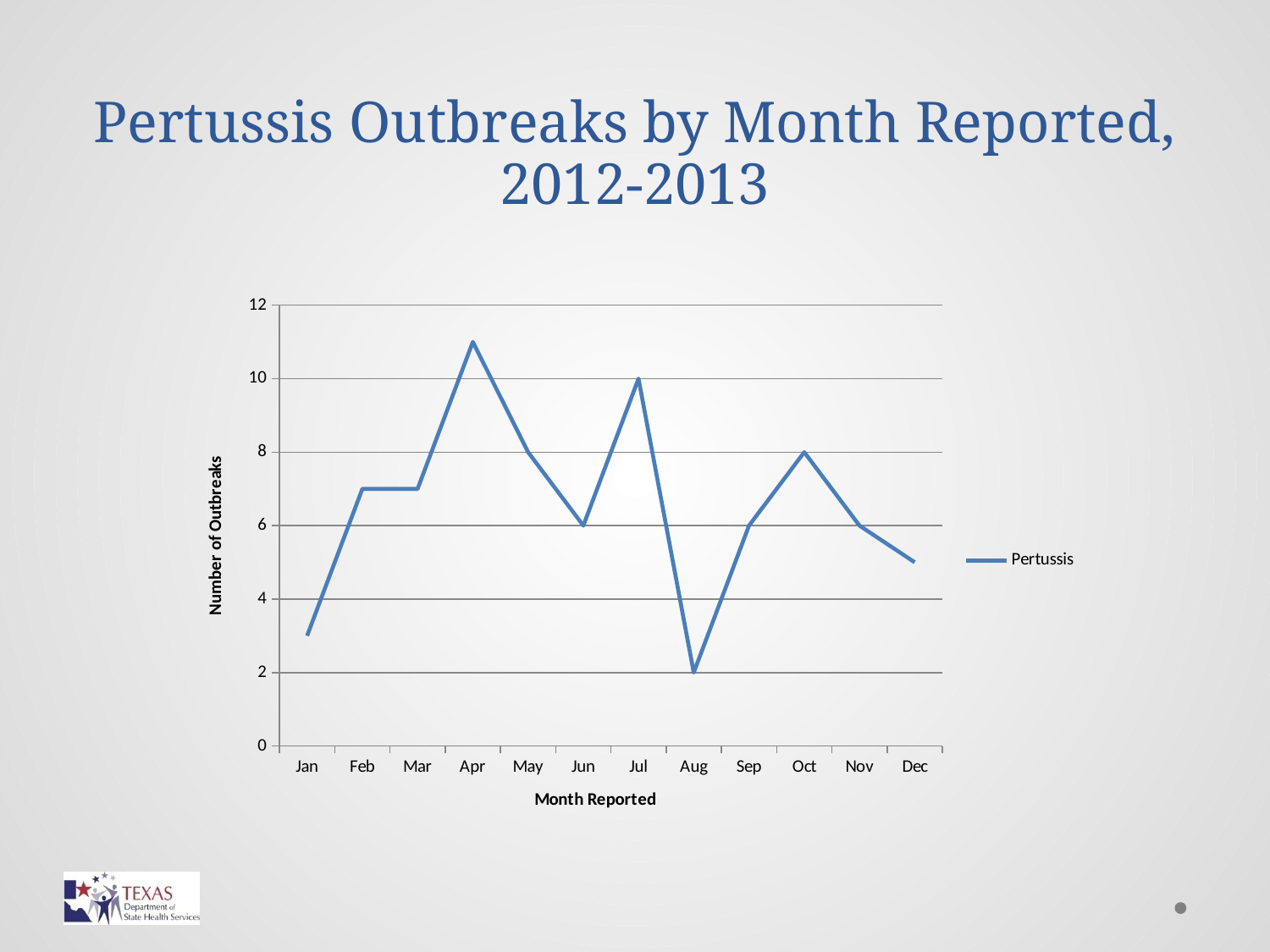
Is the value for Apr greater or less than 10? greater How many outbreaks were reported in Jul? 10 Is the value for Jan greater or less than 4? less Which month has the highest number of pertussis outbreaks? Apr Which month has the lowest number of pertussis outbreaks? Aug How many outbreaks were reported in Oct? 8 Which month has more outbreaks, Jul or Oct? Jul How many series does the legend list? 1 How many outbreaks were reported in Aug? 2 How many months are plotted on the x axis? 12 What type of chart is shown on the slide? Line chart What is the difference between the number of outbreaks in Jul and Aug? 8